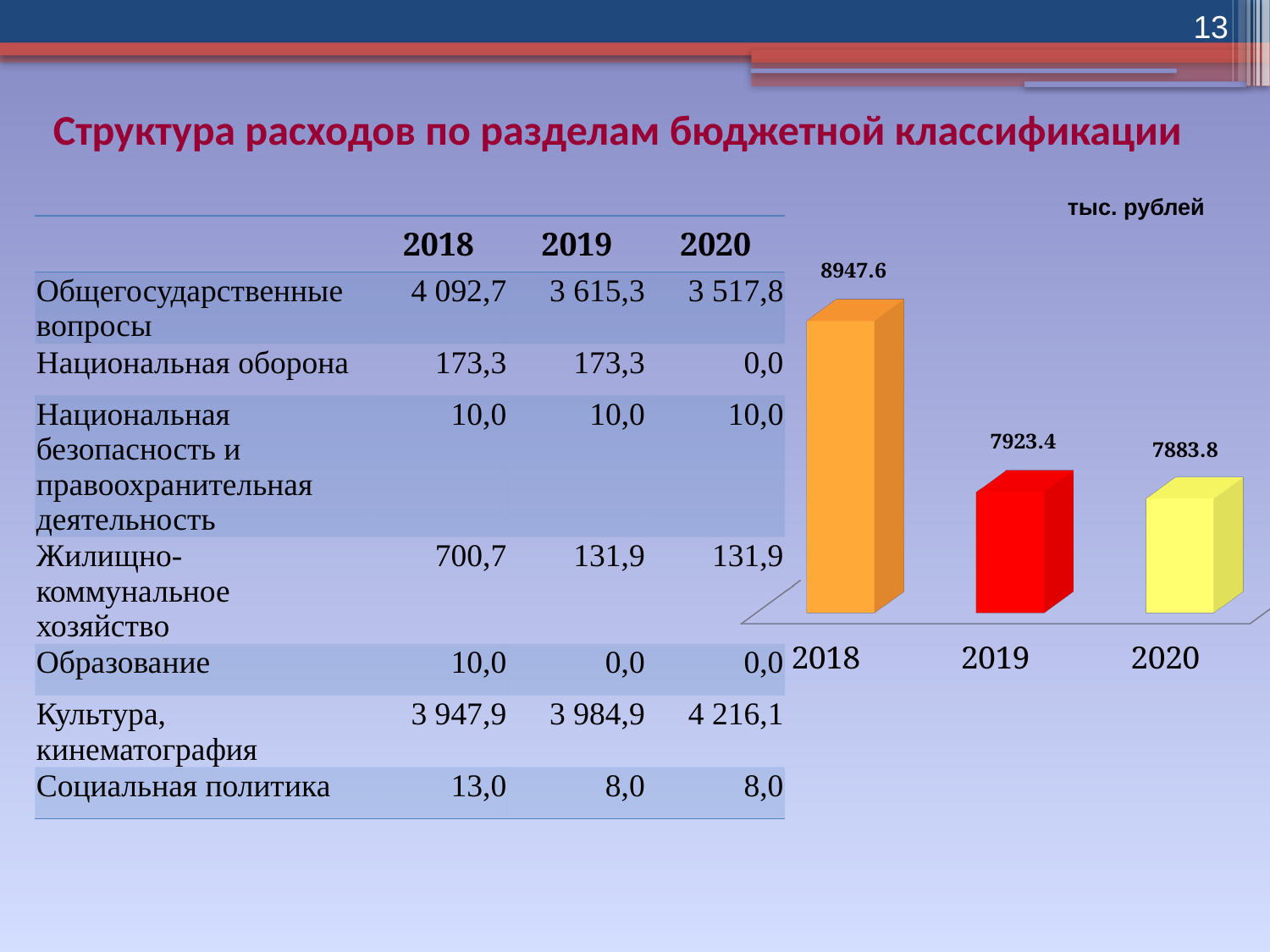
What is the difference between the 2019 and 2020 values in the chart? 39.6 Do the values in the chart rise or fall from 2018 to 2020? fall Which year has the highest bar in the chart? 2018 What is the difference between the 2018 and 2019 values in the chart? 1024.2 What is the value of the bar for 2019 in the chart? 7923.4 What type of chart is shown on the slide? bar chart What is the value of the bar for 2018 in the chart? 8947.6 What unit is indicated above the chart? тыс. рублей How many bars are plotted in the chart? 3 Which is larger in the chart, the value for 2019 or the value for 2020? 2019 What is the value of the bar for 2020 in the chart? 7883.8 Which year has the lowest bar in the chart? 2020